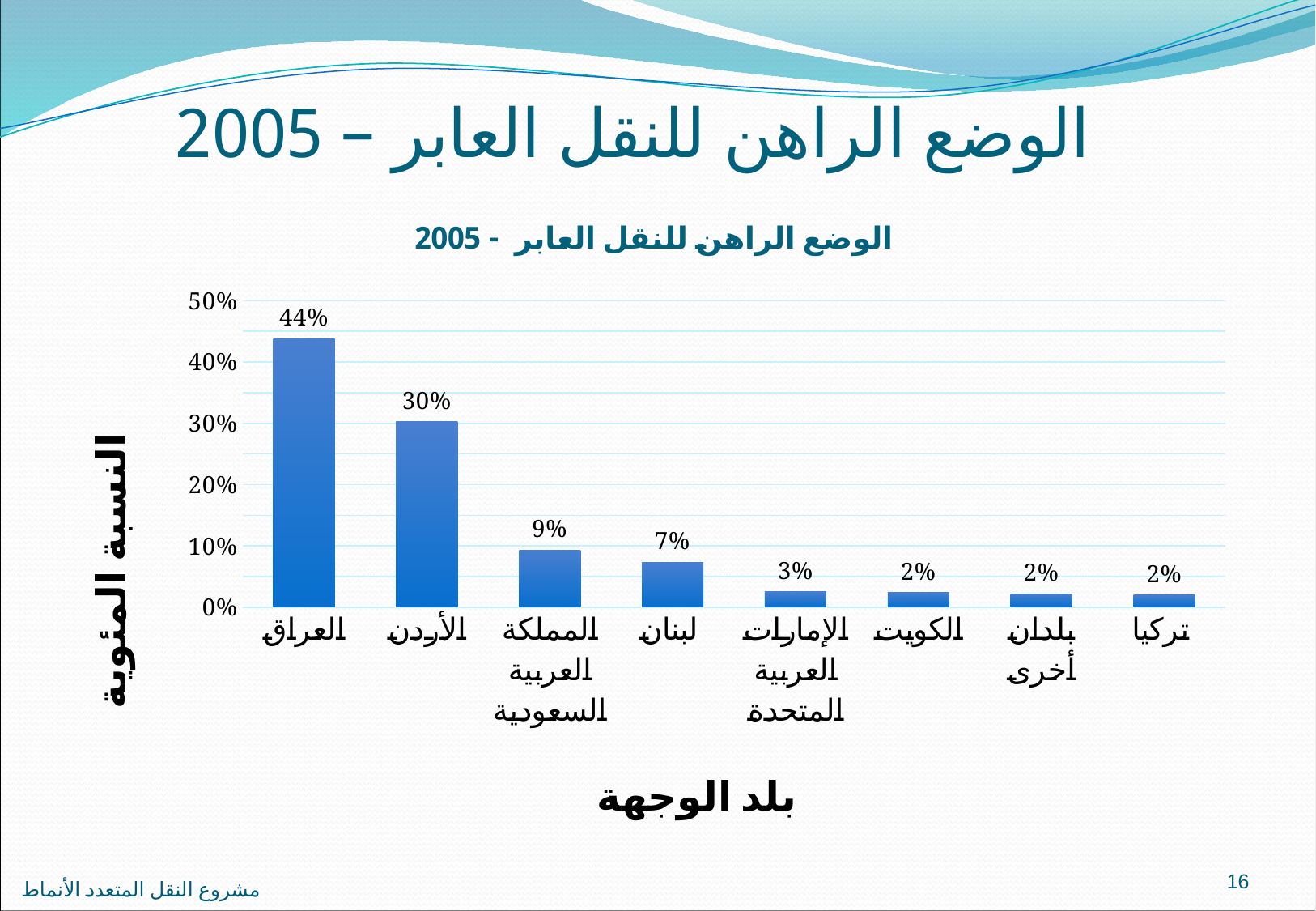
What is the value for العراق? 44% How many categories are shown on the x axis? 8 What is the value for الإمارات العربية المتحدة? 3% What is the difference between the values for العراق and الأردن? 14% What is the label of the x axis? بلد الوجهة What kind of chart is shown on the slide? bar chart What is the value for الأردن? 30% What is the value for المملكة العربية السعودية? 9% What is the title of the chart? الوضع الراهن للنقل العابر - 2005 Which category has the highest value? العراق What is the value for لبنان? 7% Which is larger, the value for المملكة العربية السعودية or the value for لبنان? المملكة العربية السعودية